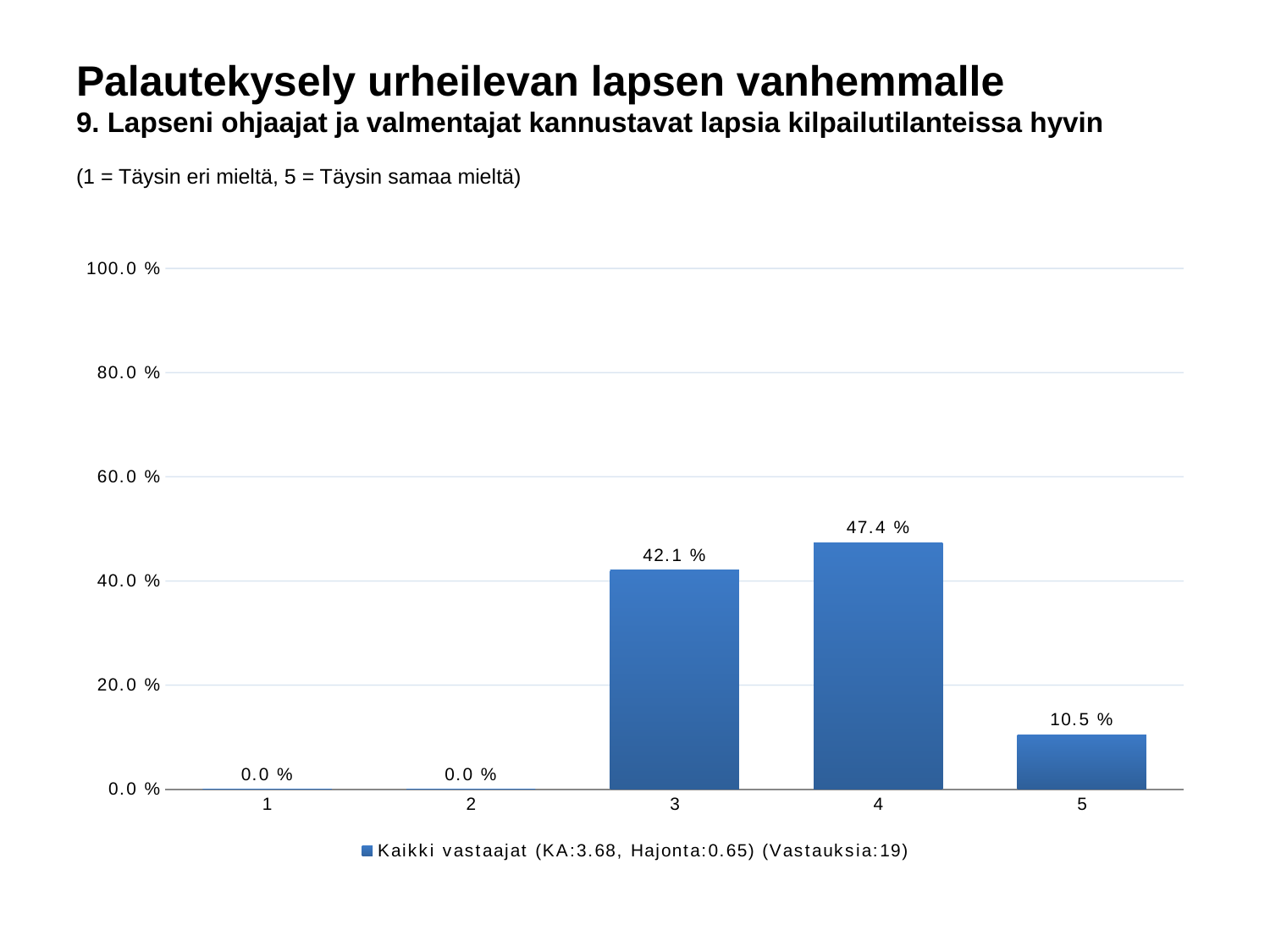
Which category has the highest value? 4 How many responses (Vastauksia) does the legend report? 19 What is the value for category 5? 10.5 % Is the value for category 4 greater or less than 40.0 %? greater What is the value for category 4? 47.4 % What kind of chart is shown on the slide? bar chart What is the value for category 1? 0.0 % What is the value for category 3? 42.1 % What is the difference between the values for category 3 and category 5? 31.6 % Which is larger, the value for category 3 or the value for category 5? 3 What is the difference between the values for category 4 and category 3? 5.3 % How many categories are shown on the x axis? 5